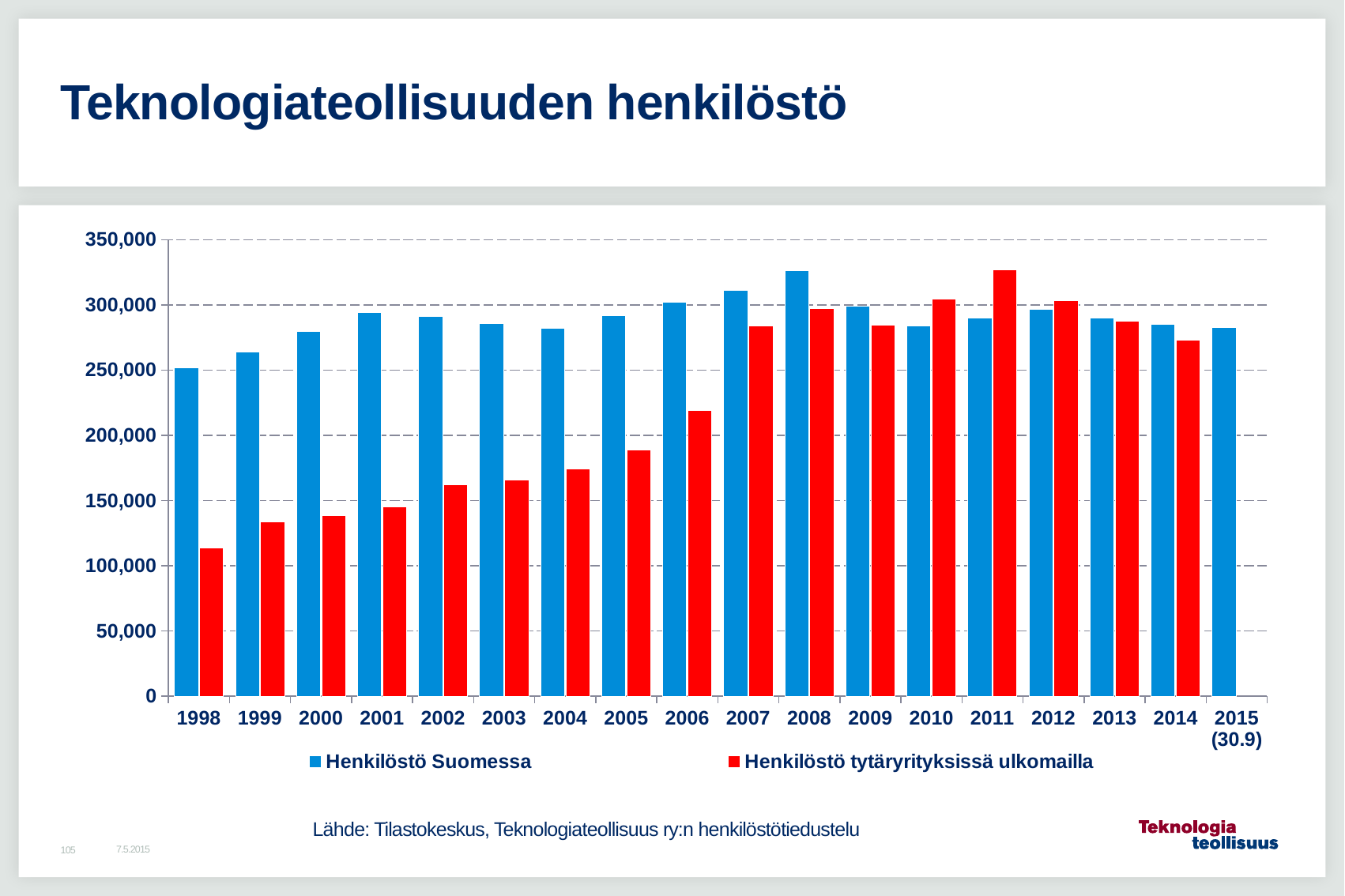
In which year is Henkilöstö tytäryrityksissä ulkomailla lowest? 1998 In 2006, which is larger: Henkilöstö Suomessa or Henkilöstö tytäryrityksissä ulkomailla? Henkilöstö Suomessa What kind of chart is shown on the slide? bar chart Is the value for Henkilöstö Suomessa in 2008 greater or less than 300,000? greater In 2011, which is larger: Henkilöstö Suomessa or Henkilöstö tytäryrityksissä ulkomailla? Henkilöstö tytäryrityksissä ulkomailla Does Henkilöstö tytäryrityksissä ulkomailla rise or fall from 1998 to 2011? rise In which year is Henkilöstö tytäryrityksissä ulkomailla highest? 2011 Is the value for Henkilöstö tytäryrityksissä ulkomailla in 2006 greater or less than 200,000? greater In which year is Henkilöstö Suomessa highest? 2008 How many series does the legend list? 2 Is the value for Henkilöstö tytäryrityksissä ulkomailla in 1998 greater or less than 150,000? less How many years (categories) are shown on the x axis? 18